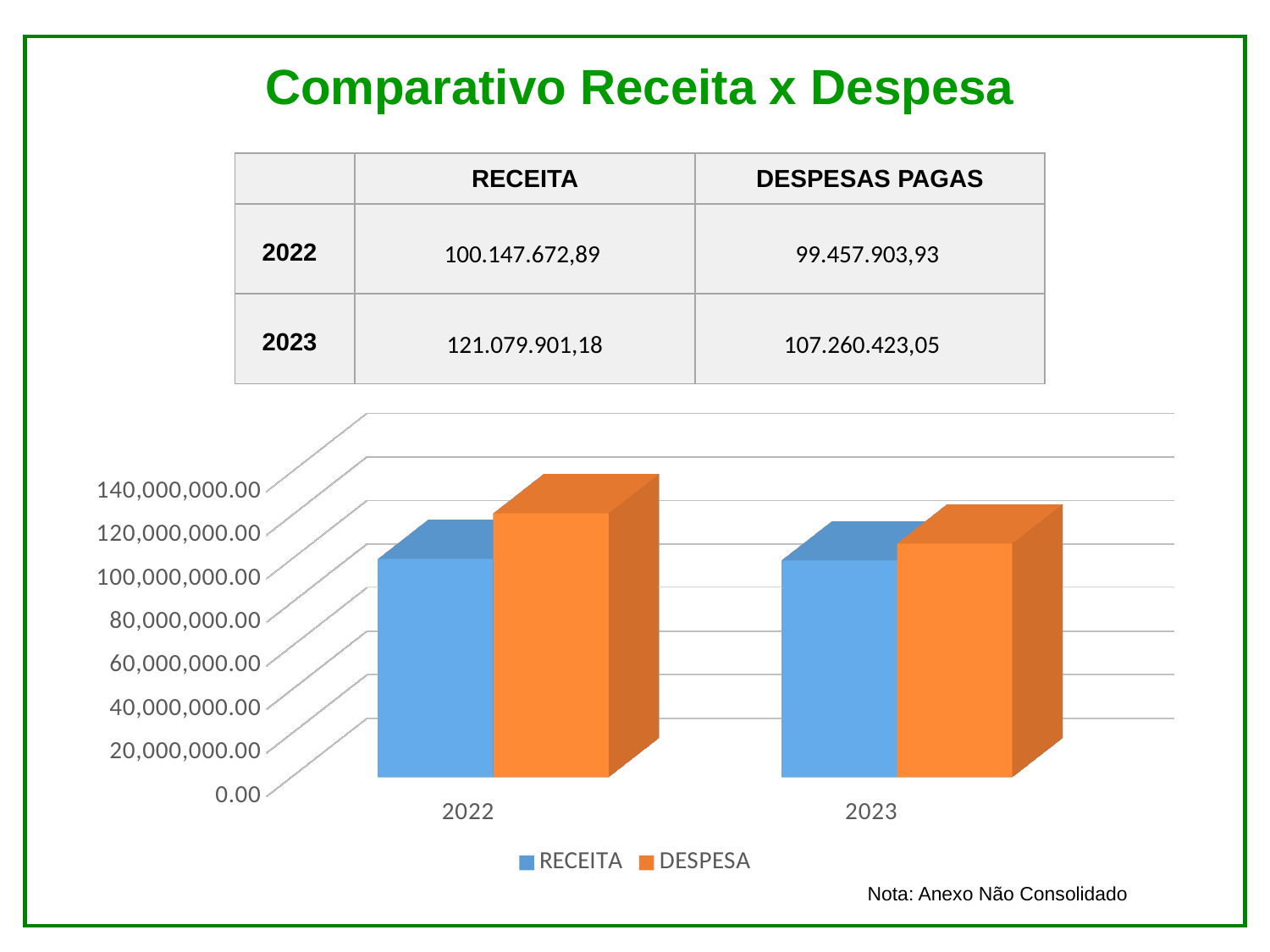
How many series does the chart legend list? 2 What kind of chart is shown on the slide? bar chart According to the table, what is the difference between RECEITA and DESPESAS PAGAS in 2023? 13.819.478,13 What are the two series named in the chart legend? RECEITA and DESPESA According to the table, what is the RECEITA value for 2023? 121.079.901,18 How many year categories are shown on the chart's x axis? 2 According to the table, does RECEITA rise or fall from 2022 to 2023? rise What is the title of the slide above the chart? Comparativo Receita x Despesa According to the table, what is the RECEITA value for 2022? 100.147.672,89 According to the table, what is the DESPESAS PAGAS value for 2023? 107.260.423,05 According to the table, what is the DESPESAS PAGAS value for 2022? 99.457.903,93 According to the table, which year has the higher RECEITA? 2023